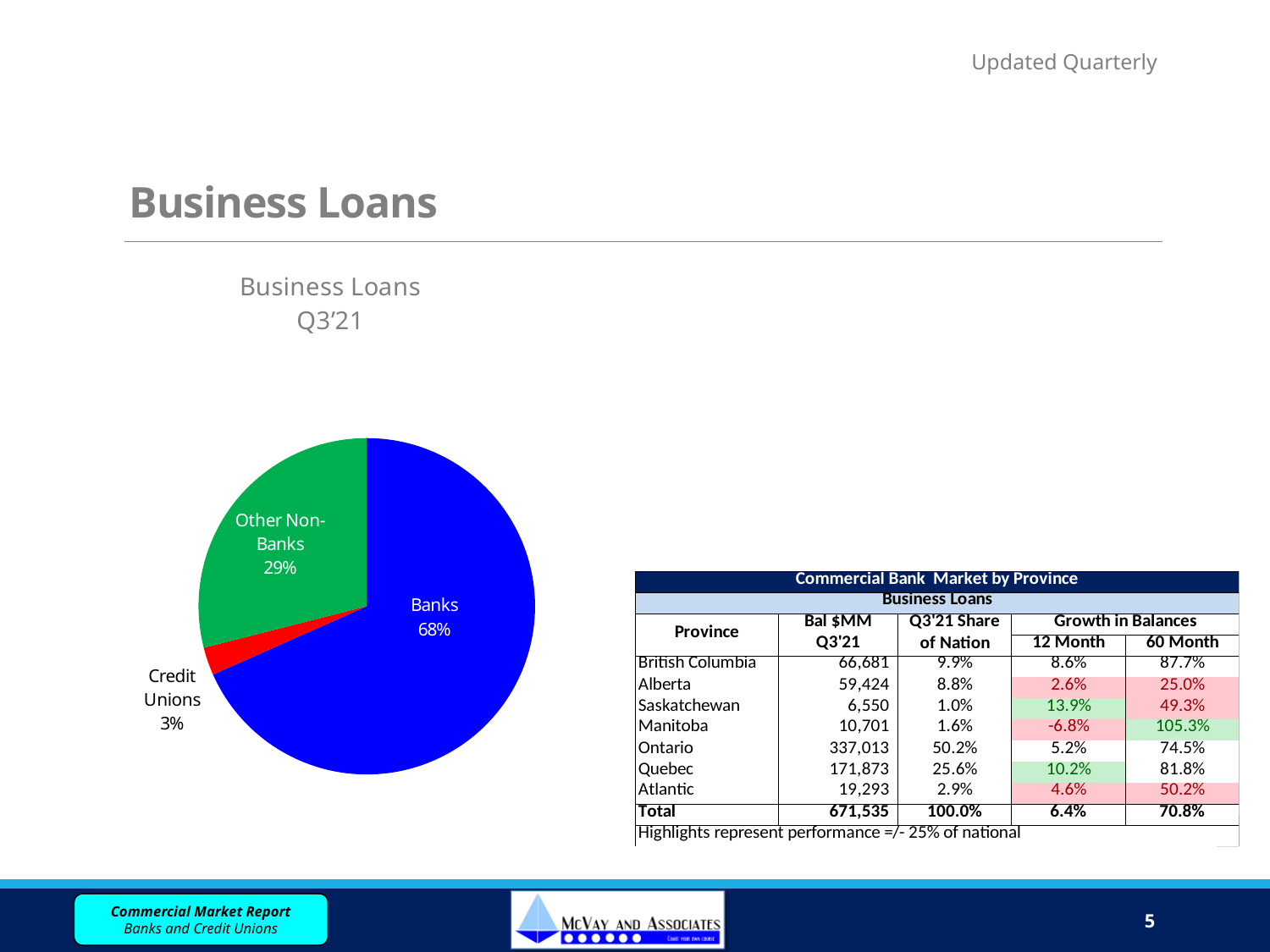
How many slices does the pie chart have? 3 What type of chart is shown on the slide? Pie chart What share of the pie chart do Banks hold? 68% Which is larger in the pie chart, Other Non-Banks or Credit Unions? Other Non-Banks What share of the pie chart do Other Non-Banks hold? 29% What colour is the Credit Unions slice in the pie chart? Red What is the title of the pie chart? Business Loans Q3'21 What is the difference in percentage points between the Banks slice and the Other Non-Banks slice? 39 Which category has the smallest slice in the pie chart? Credit Unions What is the difference in percentage points between the Other Non-Banks slice and the Credit Unions slice? 26 Which category has the largest slice in the pie chart? Banks What share of the pie chart do Credit Unions hold? 3%